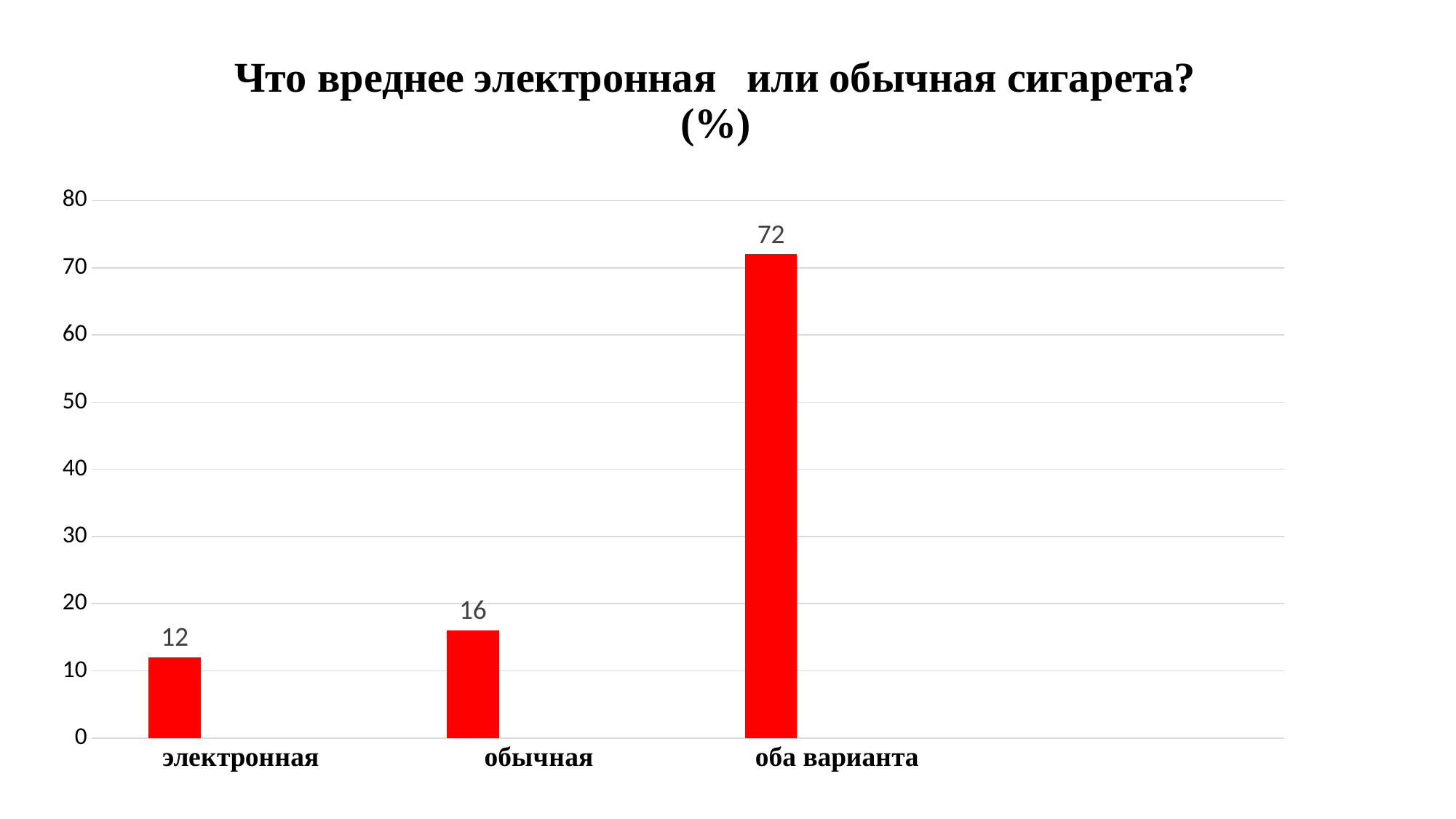
What is the value for оба варианта? 72 What kind of chart is shown on the slide? bar chart What is the title of the chart? Что вреднее электронная или обычная сигарета? (%) How many categories are shown on the x axis? 3 Is the value for оба варианта greater or less than 70? greater What is the value for обычная? 16 What is the value for электронная? 12 Which is larger, the value for обычная or the value for электронная? обычная Which category has the highest value? оба варианта Which category has the lowest value? электронная What is the difference between the values for оба варианта and обычная? 56 What is the difference between the values for обычная and электронная? 4